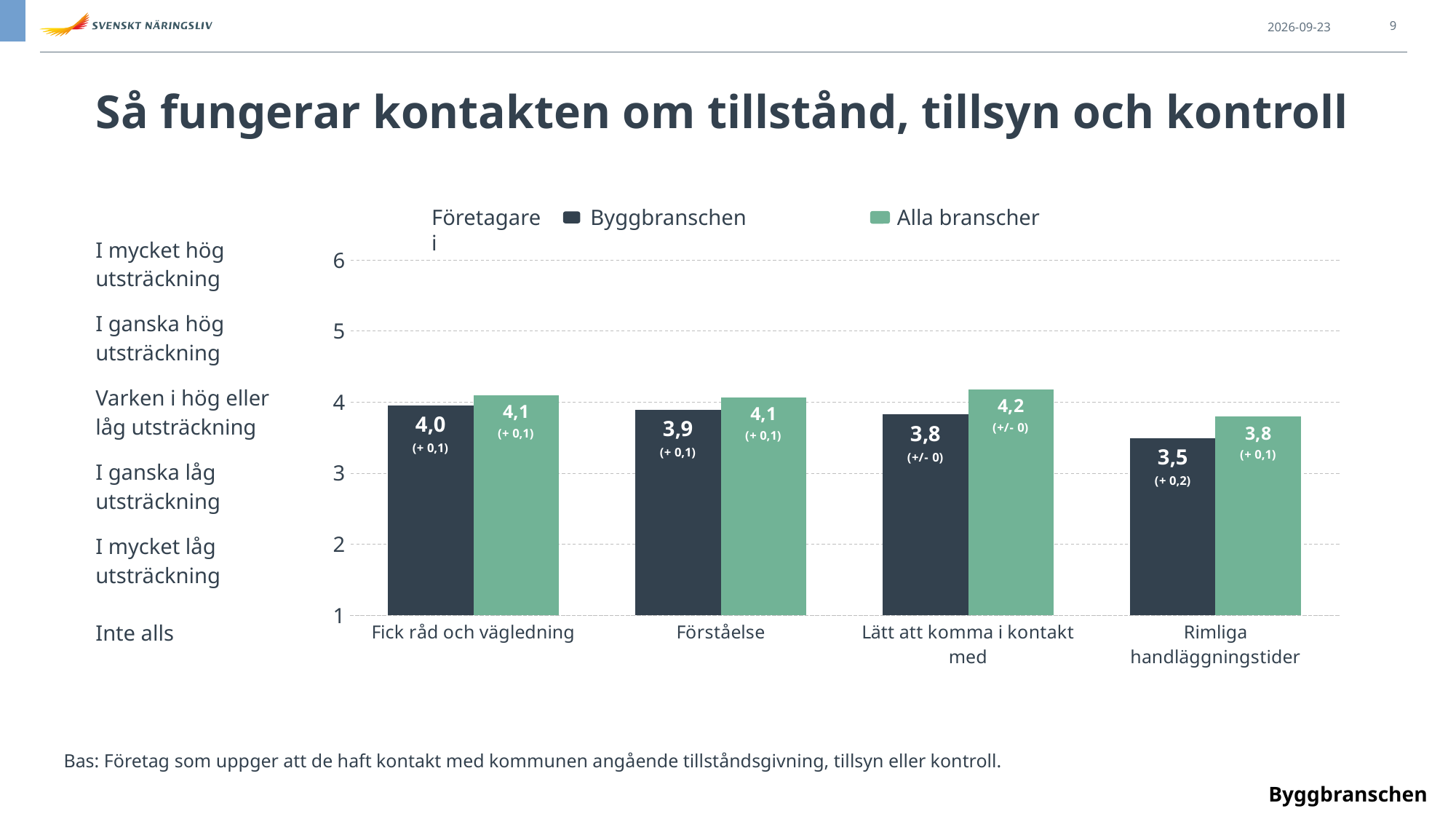
How many categories are shown on the x axis of the chart? 4 What is the value for Byggbranschen in the category Rimliga handläggningstider? 3,5 What is the value for Byggbranschen in the category Fick råd och vägledning? 4,0 How many data series does the chart plot? 2 What is the value for Alla branscher in the category Förståelse? 4,1 In the category Lätt att komma i kontakt med, which series has the larger value, Byggbranschen or Alla branscher? Alla branscher What kind of chart is shown on the slide? Bar chart What is the value for Alla branscher in the category Lätt att komma i kontakt med? 4,2 Which category has the lowest value for Byggbranschen? Rimliga handläggningstider Is the value for Byggbranschen in the category Förståelse greater or less than 3? greater What is the difference between Alla branscher and Byggbranschen in the category Rimliga handläggningstider? 0,3 Which category has the highest value for Alla branscher? Lätt att komma i kontakt med